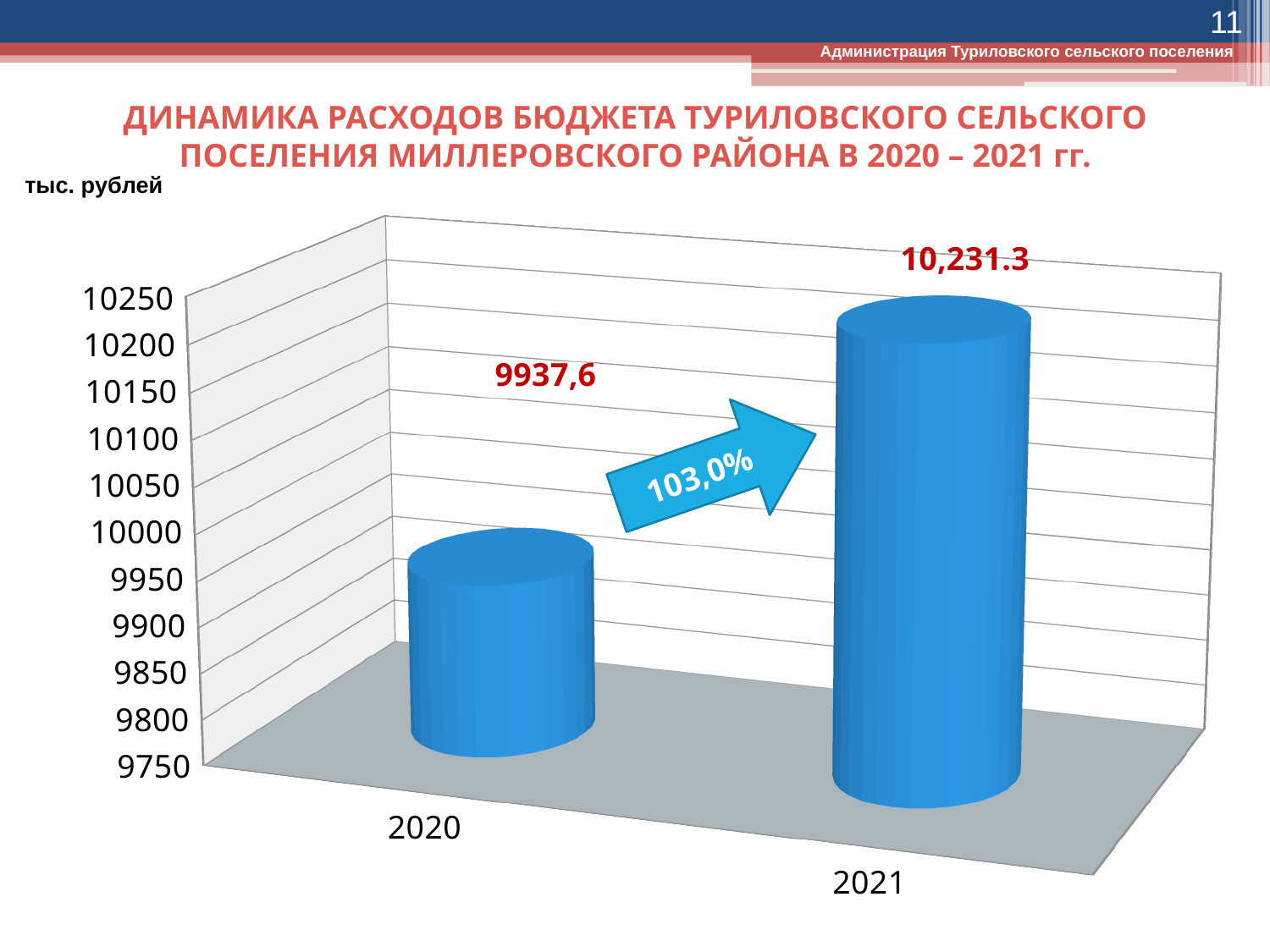
How many years (categories) are shown in the chart? 2 What is the value for 2020? 9937,6 What percentage is written on the arrow between the two bars? 103,0% Is the value for 2021 greater or less than 10200? greater Is the value for 2020 greater or less than 10000? less Which year has the highest value? 2021 Do the values rise or fall from 2020 to 2021? rise Which is larger, the value for 2020 or the value for 2021? 2021 Which year has the lowest value? 2020 What is the value for 2021? 10,231.3 What is the difference between the values for 2021 and 2020? 293,7 What kind of chart is shown on the slide? bar chart